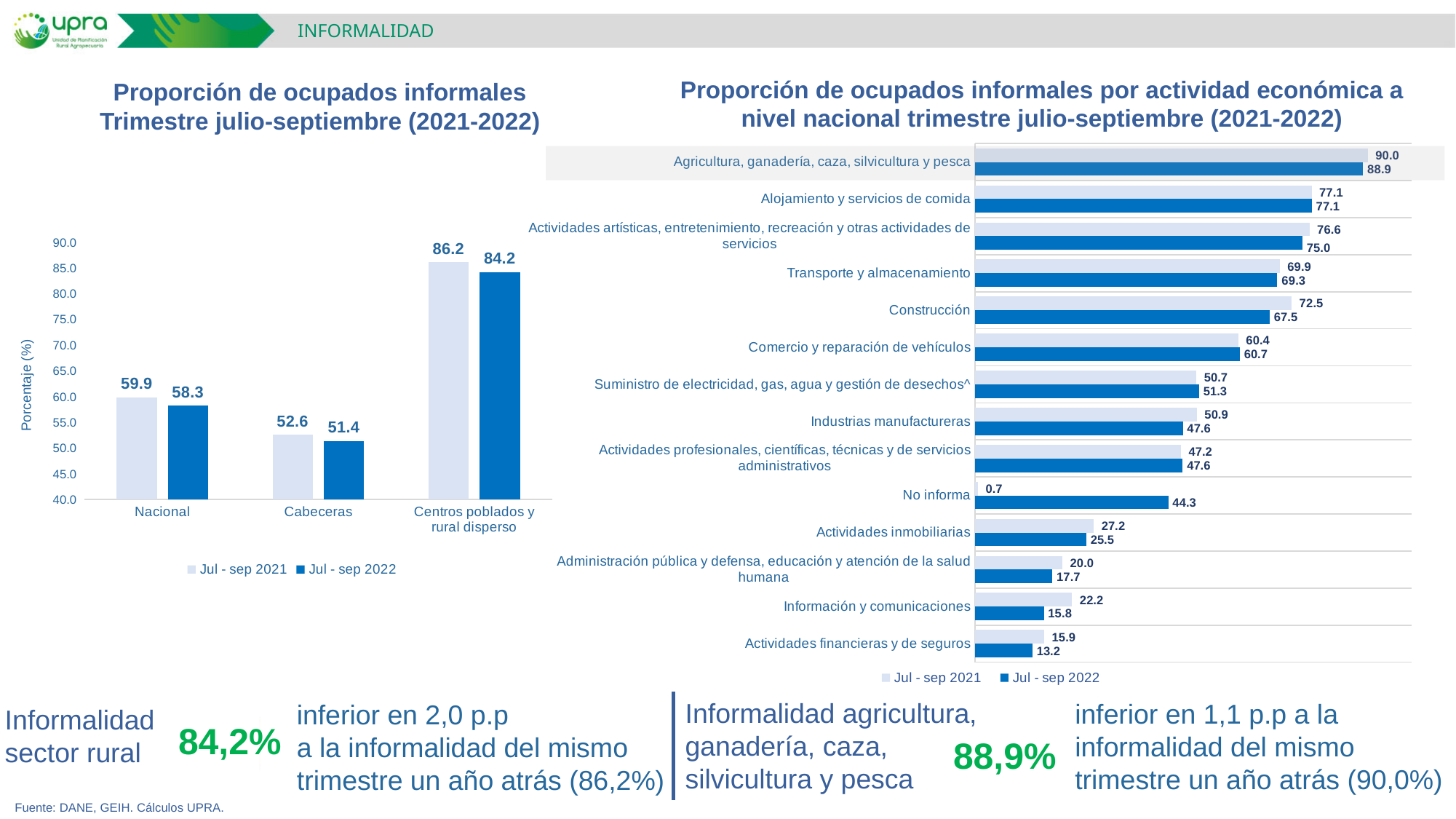
In the right chart 'Proporción de ocupados informales por actividad económica', what is the difference between the Jul - sep 2021 and Jul - sep 2022 values for Información y comunicaciones? 6.4 In the right chart 'Proporción de ocupados informales por actividad económica', what is the Jul - sep 2021 value for No informa? 0.7 In the right chart 'Proporción de ocupados informales por actividad económica', which activity has the lowest Jul - sep 2022 value? Actividades financieras y de seguros In the left chart 'Proporción de ocupados informales Trimestre julio-septiembre (2021-2022)', what is the value for Nacional in Jul - sep 2022? 58.3 In the right chart 'Proporción de ocupados informales por actividad económica', how many series does the legend list? 2 In the left chart 'Proporción de ocupados informales Trimestre julio-septiembre (2021-2022)', which category has the highest value in Jul - sep 2022? Centros poblados y rural disperso In the left chart 'Proporción de ocupados informales Trimestre julio-septiembre (2021-2022)', what is the value for Cabeceras in Jul - sep 2021? 52.6 In the left chart 'Proporción de ocupados informales Trimestre julio-septiembre (2021-2022)', what kind of chart is it? Bar chart In the left chart 'Proporción de ocupados informales Trimestre julio-septiembre (2021-2022)', what is the difference between the Jul - sep 2021 and Jul - sep 2022 values for Centros poblados y rural disperso? 2.0 In the left chart 'Proporción de ocupados informales Trimestre julio-septiembre (2021-2022)', how many categories are shown on the x axis? 3 In the right chart 'Proporción de ocupados informales por actividad económica', which is larger for Industrias manufactureras: the Jul - sep 2021 value or the Jul - sep 2022 value? Jul - sep 2021 In the right chart 'Proporción de ocupados informales por actividad económica', what is the Jul - sep 2022 value for Construcción? 67.5